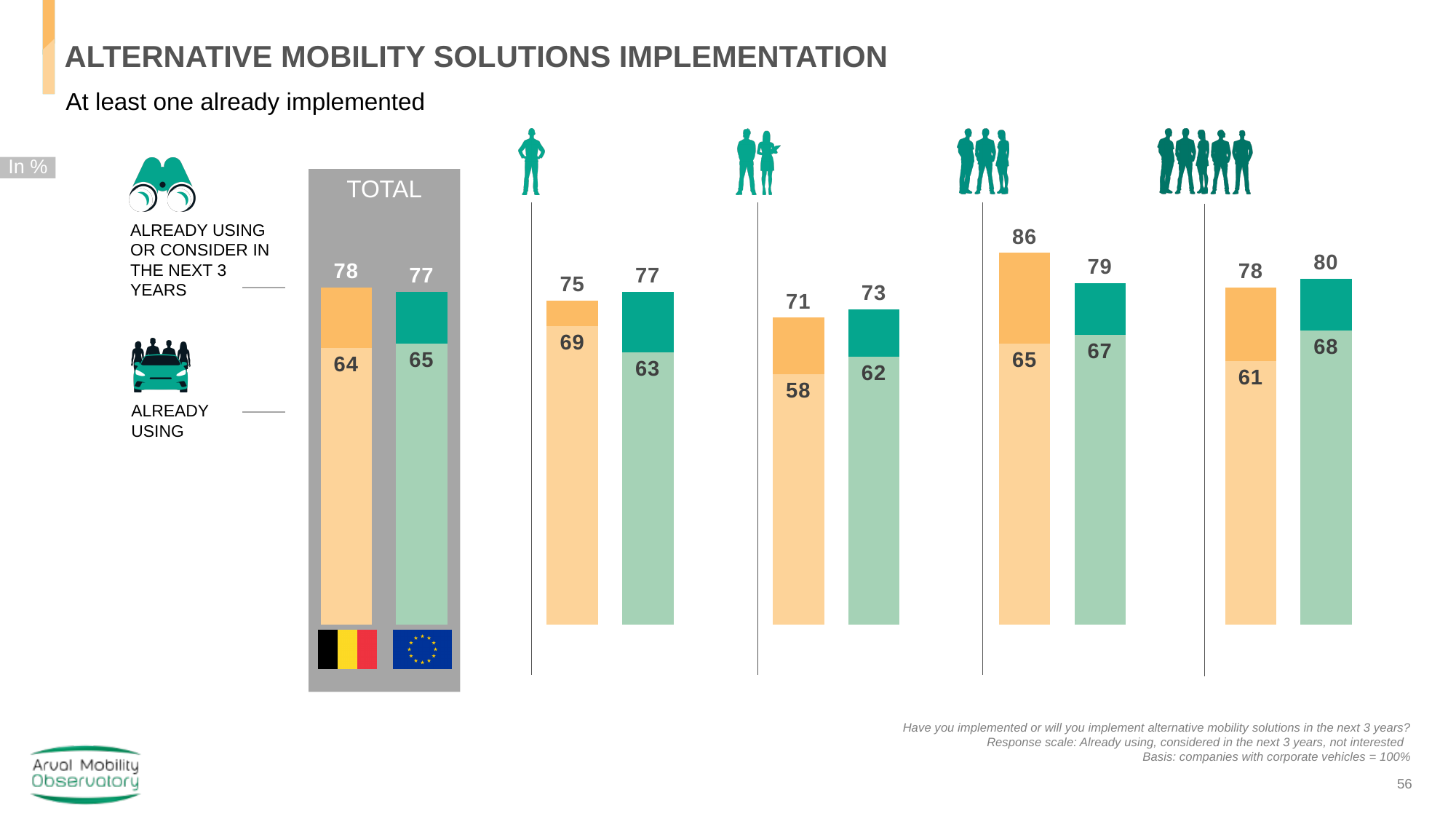
For the third company-size group (three-person icon), what is the difference between Belgium's 'Already using or consider in the next 3 years' value and its 'Already using' value? 21 What is the highest 'Already using or consider in the next 3 years' value shown on the slide? 86 In the TOTAL section, which has the higher 'Already using' value, Belgium or the EU? EU How many series does the legend on the left of the chart list? 2 In the TOTAL section, what is the 'Already using' value for Belgium? 64 In what unit are the values on the chart expressed? In % In the TOTAL section, what is the 'Already using or consider in the next 3 years' value for the EU? 77 What is the lowest 'Already using' value shown on the slide? 58 How many flags are shown under the TOTAL section of the chart? 2 In the TOTAL section, what is the difference between Belgium's 'Already using or consider in the next 3 years' value and its 'Already using' value? 14 For the rightmost company-size group (four-person icon), what is the EU 'Already using' value? 68 What kind of chart is shown on the slide? Bar chart